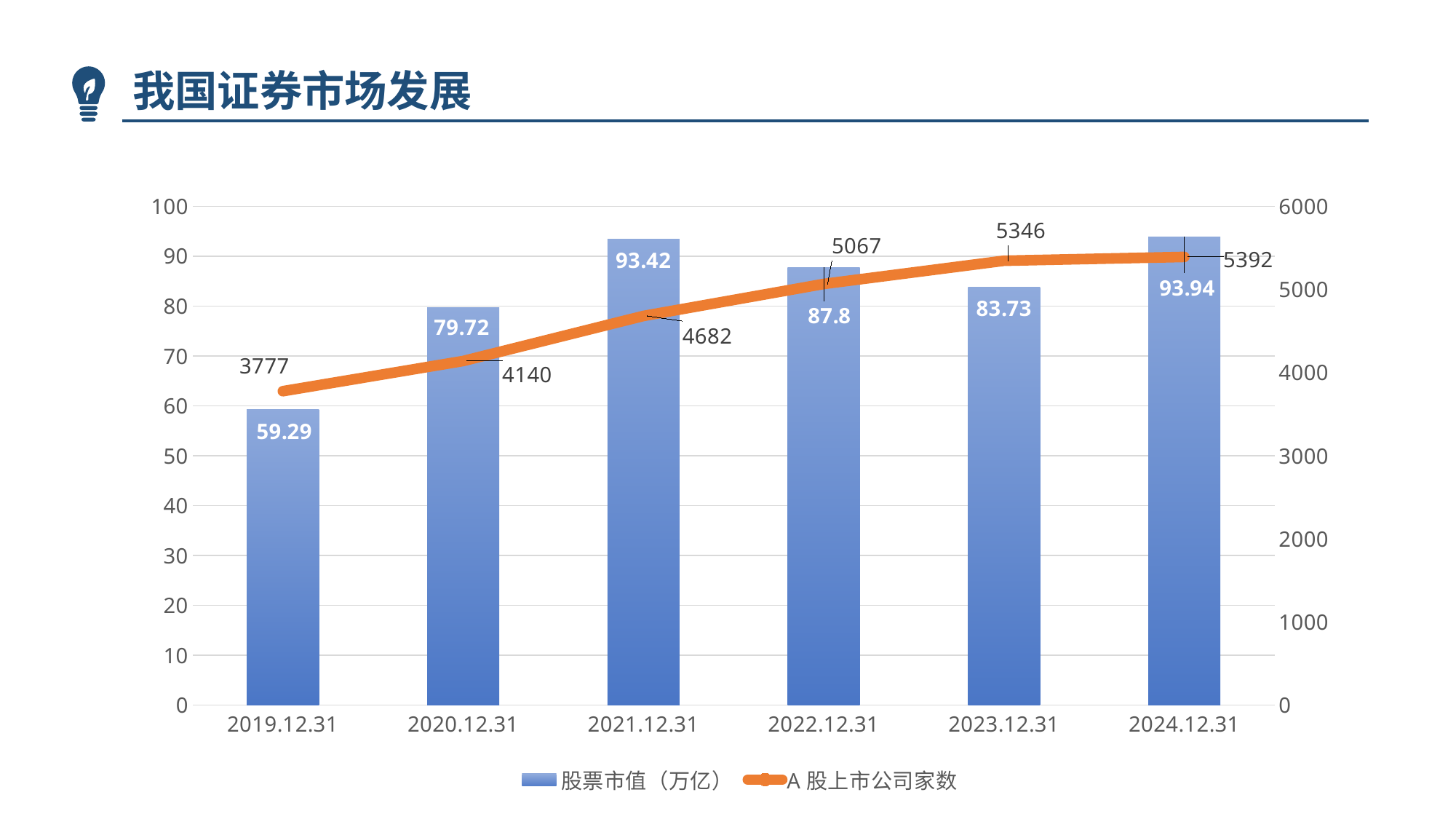
How many dates are shown on the x axis? 6 What is the A 股上市公司家数 value for 2019.12.31? 3777 How many series does the legend list? 2 Which is larger, the 股票市值（万亿）for 2022.12.31 or for 2023.12.31? 2022.12.31 What is the difference in A 股上市公司家数 between 2023.12.31 and 2022.12.31? 279 What is the A 股上市公司家数 value for 2024.12.31? 5392 What is the difference in 股票市值（万亿）between 2020.12.31 and 2019.12.31? 20.43 What is the title of the chart on this slide? 我国证券市场发展 Which date has the highest A 股上市公司家数 value? 2024.12.31 Which date has the lowest 股票市值（万亿）value? 2019.12.31 Does the A 股上市公司家数 series rise or fall from 2019.12.31 to 2024.12.31? rise What is the 股票市值（万亿）value for 2021.12.31? 93.42